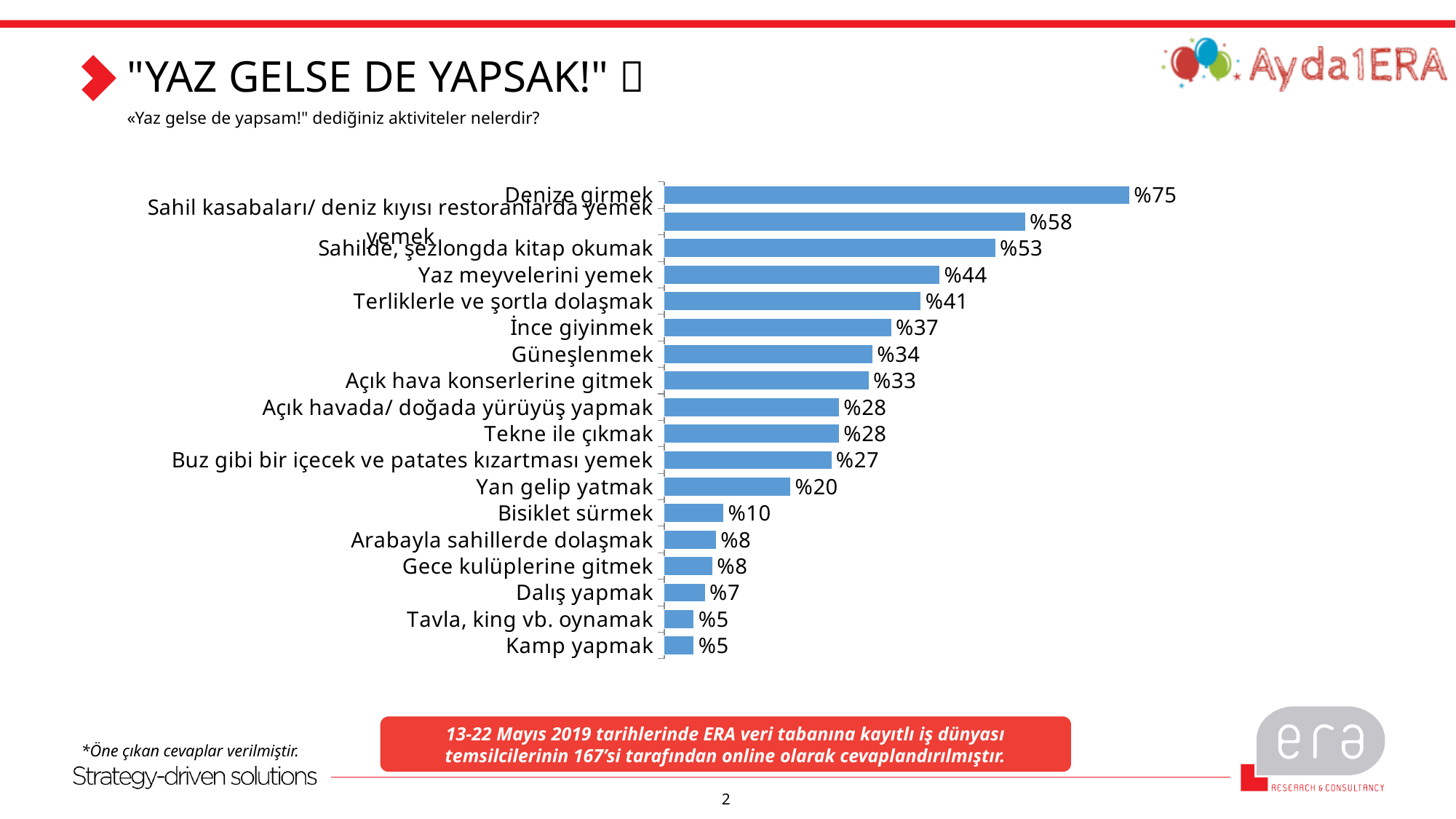
What is the difference between the values for Yan gelip yatmak and Bisiklet sürmek? %10 What is the value for Yaz meyvelerini yemek? %44 What is the value for Bisiklet sürmek? %10 What is the value for Denize girmek? %75 What is the value for Terliklerle ve şortla dolaşmak? %41 Which is larger, the value for İnce giyinmek or the value for Açık hava konserlerine gitmek? İnce giyinmek What is the value for Güneşlenmek? %34 Which is larger, the value for Dalış yapmak or the value for Kamp yapmak? Dalış yapmak What is the difference between the values for Denize girmek and Sahilde, şezlongda kitap okumak? %22 Which activity has the highest value? Denize girmek How many activities are shown in the chart? 18 What kind of chart is shown on the slide? Bar chart